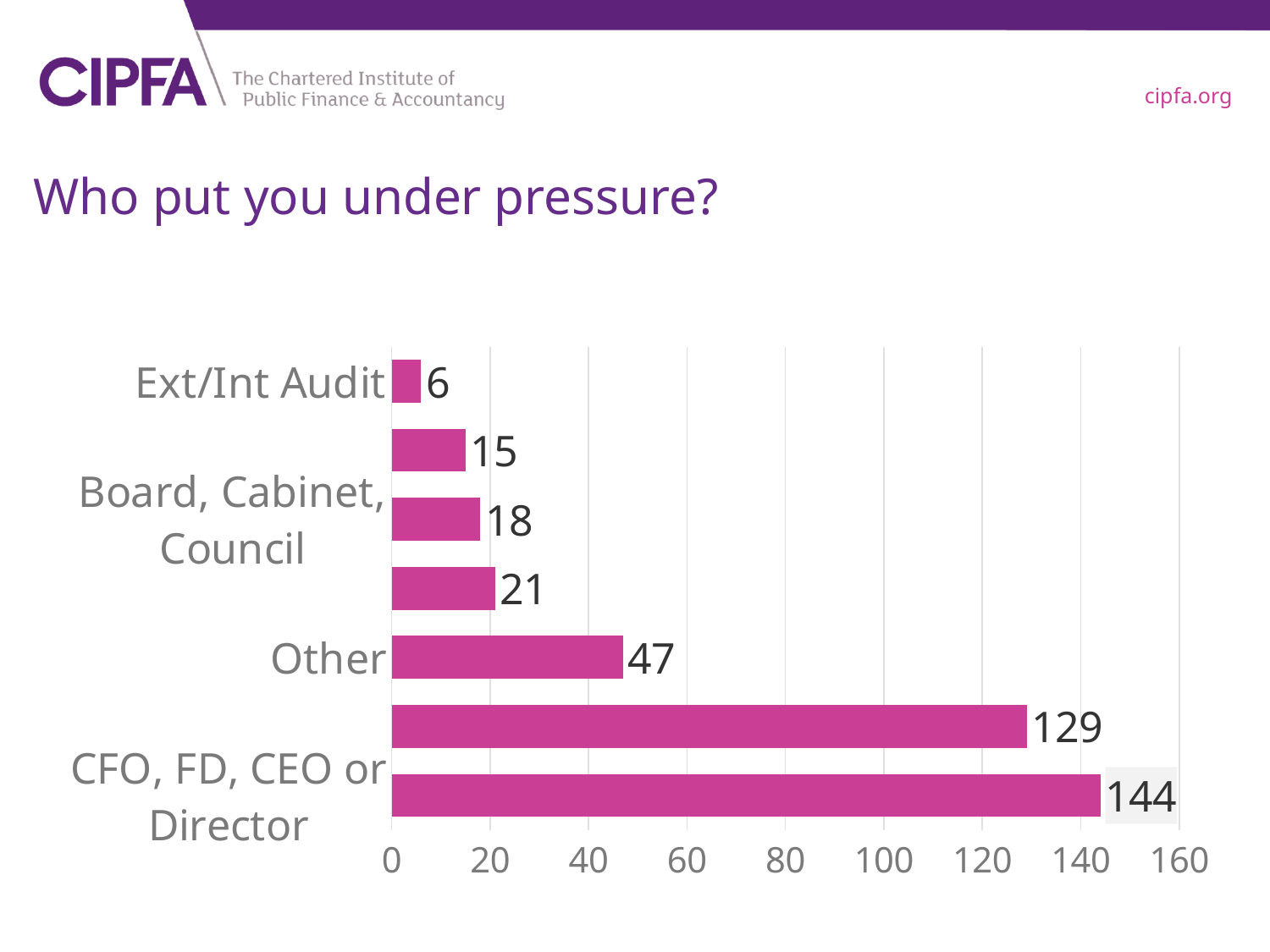
What is the highest value shown on the horizontal axis? 160 What kind of chart is shown on the slide? bar chart What is the value for Ext/Int Audit? 6 Which category has the lowest value? Ext/Int Audit What is the difference between the two largest values on the chart? 15 Is the value for Other greater or less than 40? greater How many bars are plotted on the chart? 7 What is the largest value shown on the chart? 144 What is the difference between the value for Other and the value for Ext/Int Audit? 41 What is the title of the chart? Who put you under pressure? What is the value for Other? 47 Which is larger, the value for Other or the value for Ext/Int Audit? Other